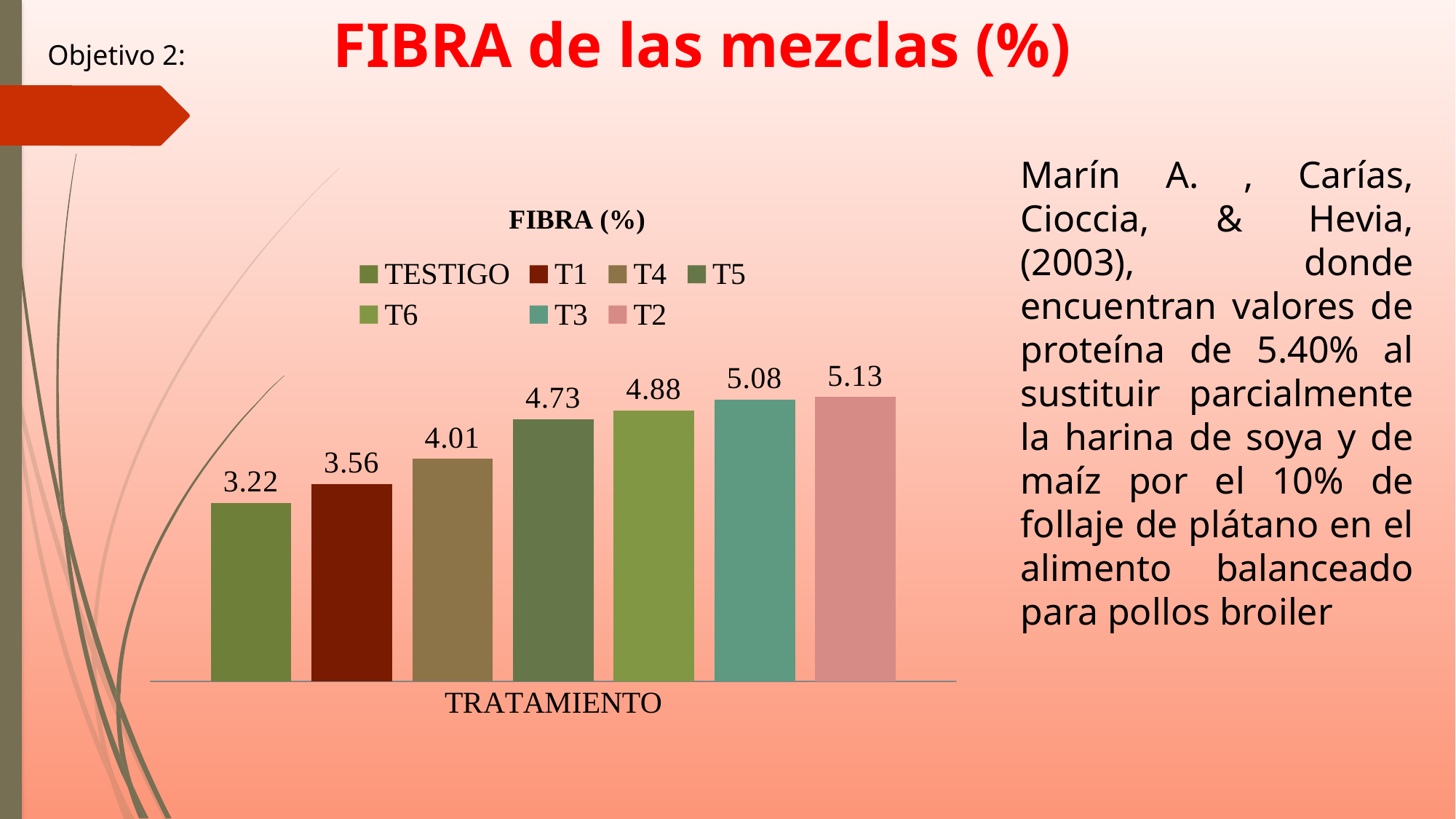
What is the FIBRA (%) value for T3? 5.08 Which has a larger FIBRA (%) value, T1 or T4? T4 What is the difference between the FIBRA (%) values of T2 and TESTIGO? 1.91 What is the label of the horizontal axis of the chart? TRATAMIENTO How many entries does the legend of the FIBRA (%) chart list? 7 What is the difference between the FIBRA (%) values of T6 and T4? 0.87 What is the FIBRA (%) value for TESTIGO? 3.22 Which treatment has the lowest FIBRA (%) value? TESTIGO What is the FIBRA (%) value for T5? 4.73 Which treatment has the highest FIBRA (%) value? T2 How many treatments are plotted in the FIBRA (%) chart? 7 What kind of chart is shown on the slide? Bar chart